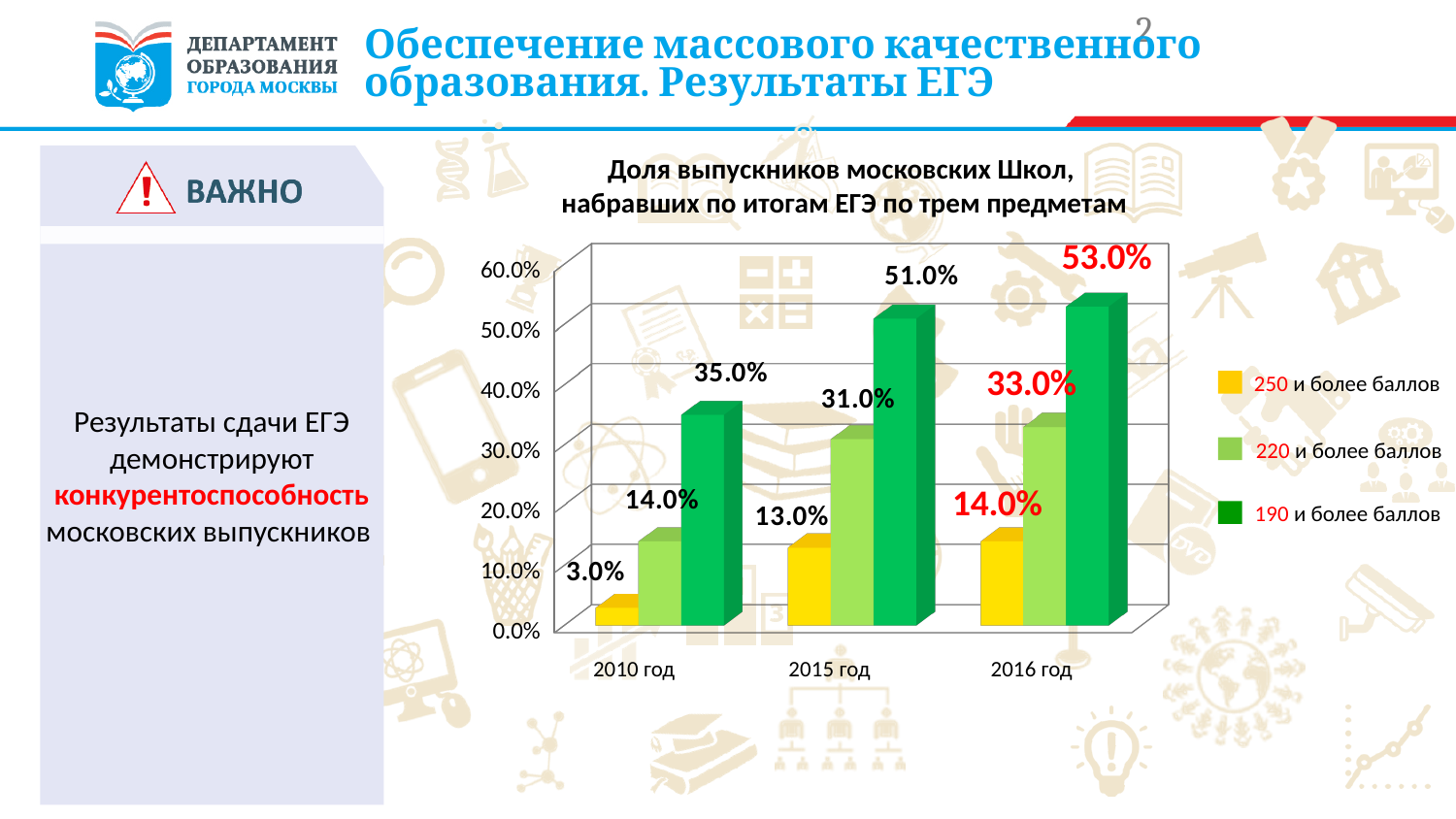
What kind of chart is shown on the slide? Bar chart Does the value for 250 и более баллов rise or fall from 2010 год to 2016 год? Rises What is the difference between the 190 и более баллов values for 2016 год and 2010 год? 18.0% Which is larger: the 220 и более баллов value in 2015 год or in 2016 год? 2016 год What is the value for 250 и более баллов in 2010 год? 3.0% Which year has the highest value for 190 и более баллов? 2016 год Is the value for 190 и более баллов in 2015 год greater or less than 50.0%? greater What is the value for 220 и более баллов in 2015 год? 31.0% How many series does the legend list? 3 How many years are shown on the x axis? 3 What share of graduates scored 190 и более баллов in 2016 год? 53.0% Which year has the lowest value for 250 и более баллов? 2010 год